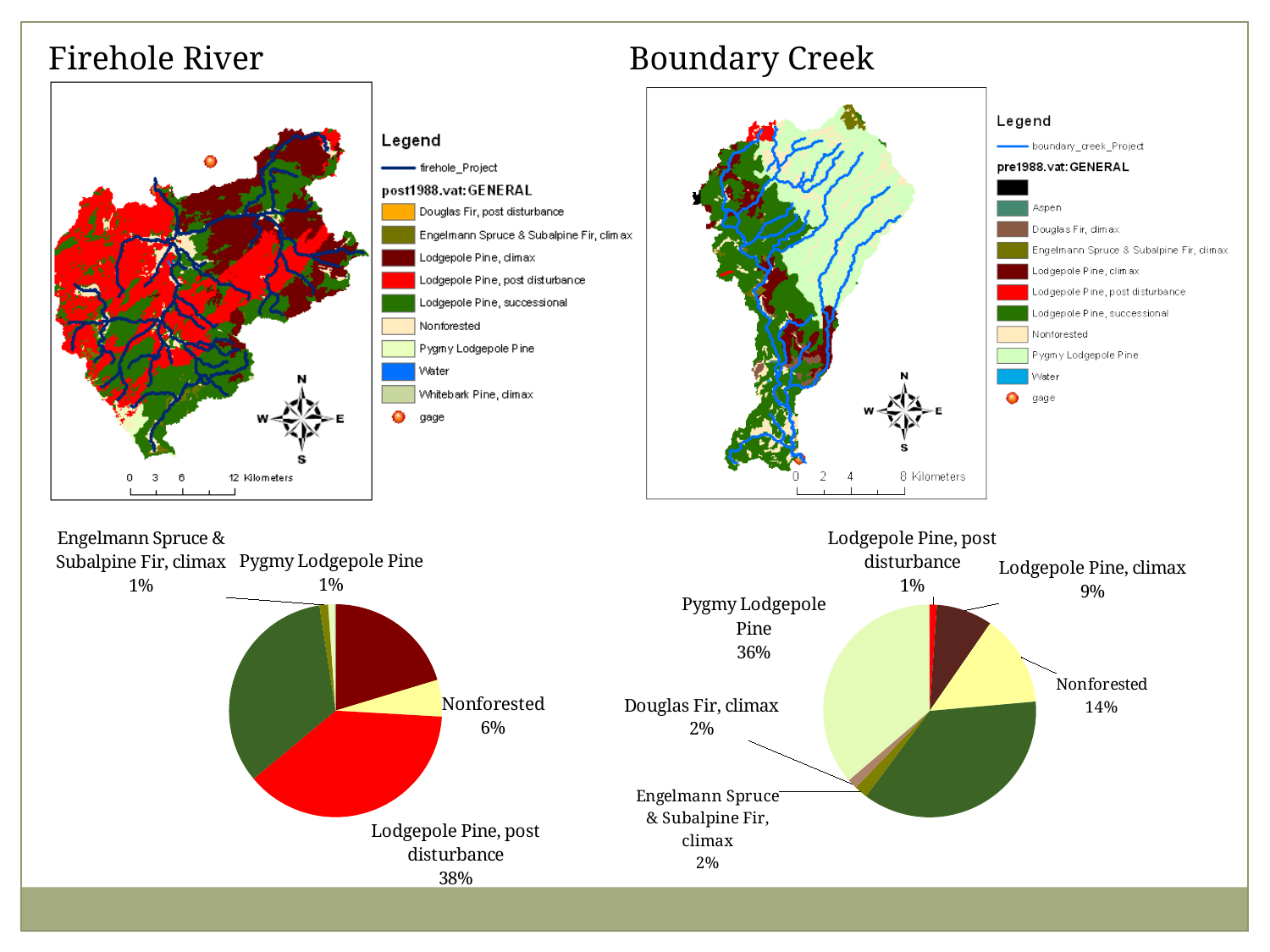
In the Firehole River pie chart, what share is Lodgepole Pine, post disturbance? 38% In the Boundary Creek pie chart, which is larger: Nonforested or Lodgepole Pine, climax? Nonforested Which chart shows the larger share for Lodgepole Pine, post disturbance: the Firehole River pie chart or the Boundary Creek pie chart? Firehole River In the Boundary Creek pie chart, what share is Pygmy Lodgepole Pine? 36% In the Firehole River pie chart, what share is Nonforested? 6% How many percentage points larger is the Nonforested share in the Boundary Creek pie chart than in the Firehole River pie chart? 8 What kind of chart is the Boundary Creek chart at the bottom right of the slide? Pie chart In the Boundary Creek pie chart, how many percentage points larger is Pygmy Lodgepole Pine than Nonforested? 22